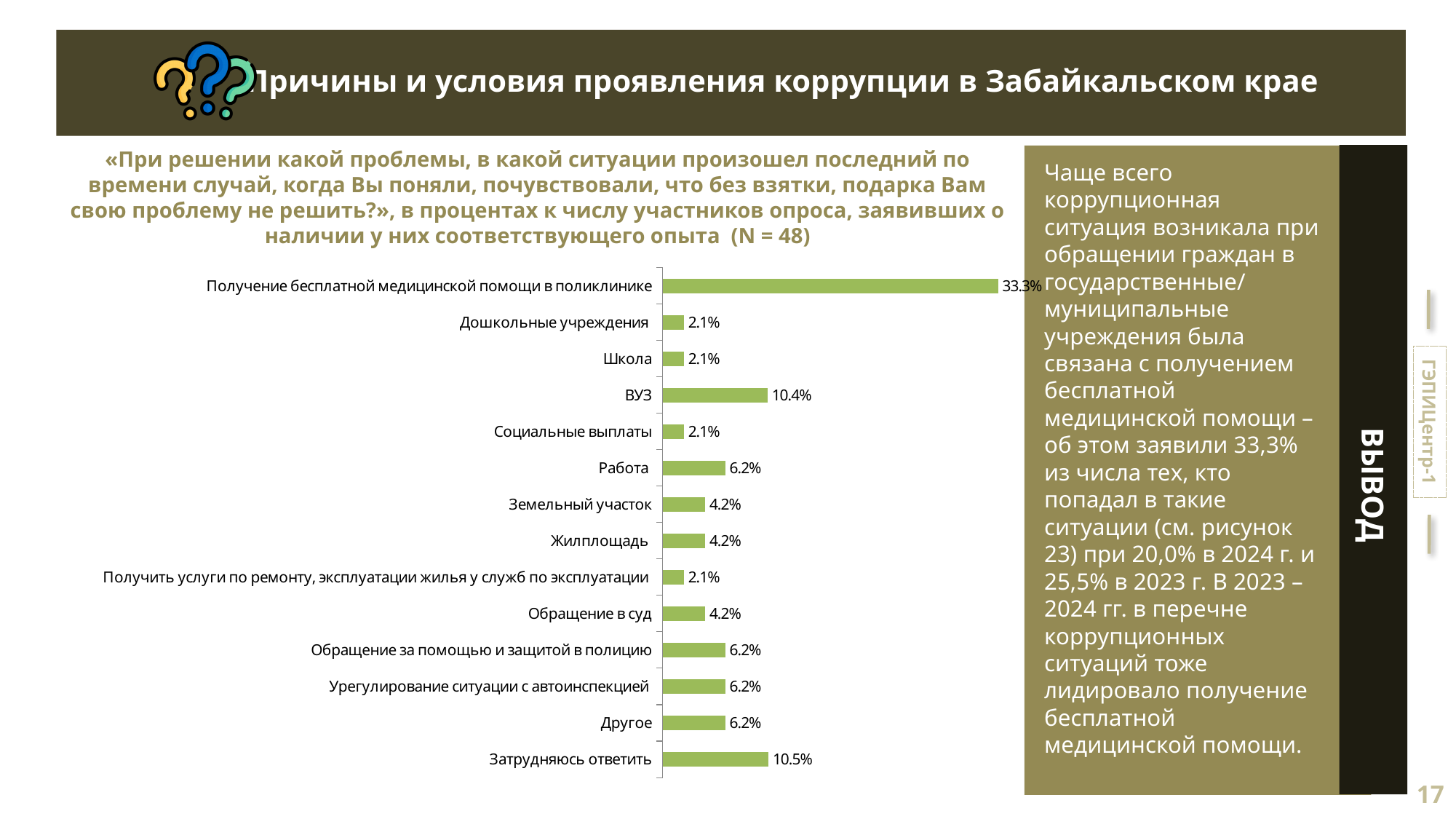
How many categories are shown in the bar chart? 14 What is the value for "Затрудняюсь ответить"? 10.5% What is the value for "Работа"? 6.2% Which category has the highest value in the chart? Получение бесплатной медицинской помощи в поликлинике What type of chart is shown on the slide? Bar chart What is the value for "Получение бесплатной медицинской помощи в поликлинике"? 33.3% What is the value for "Обращение в суд"? 4.2% What is the value for "ВУЗ"? 10.4% What is the lowest value shown in the chart? 2.1% What is the difference between the values for "Получение бесплатной медицинской помощи в поликлинике" and "ВУЗ"? 22.9 percentage points What is the sample size (N) stated in the chart title? N = 48 Which is larger: the value for "Работа" or the value for "Земельный участок"? Работа